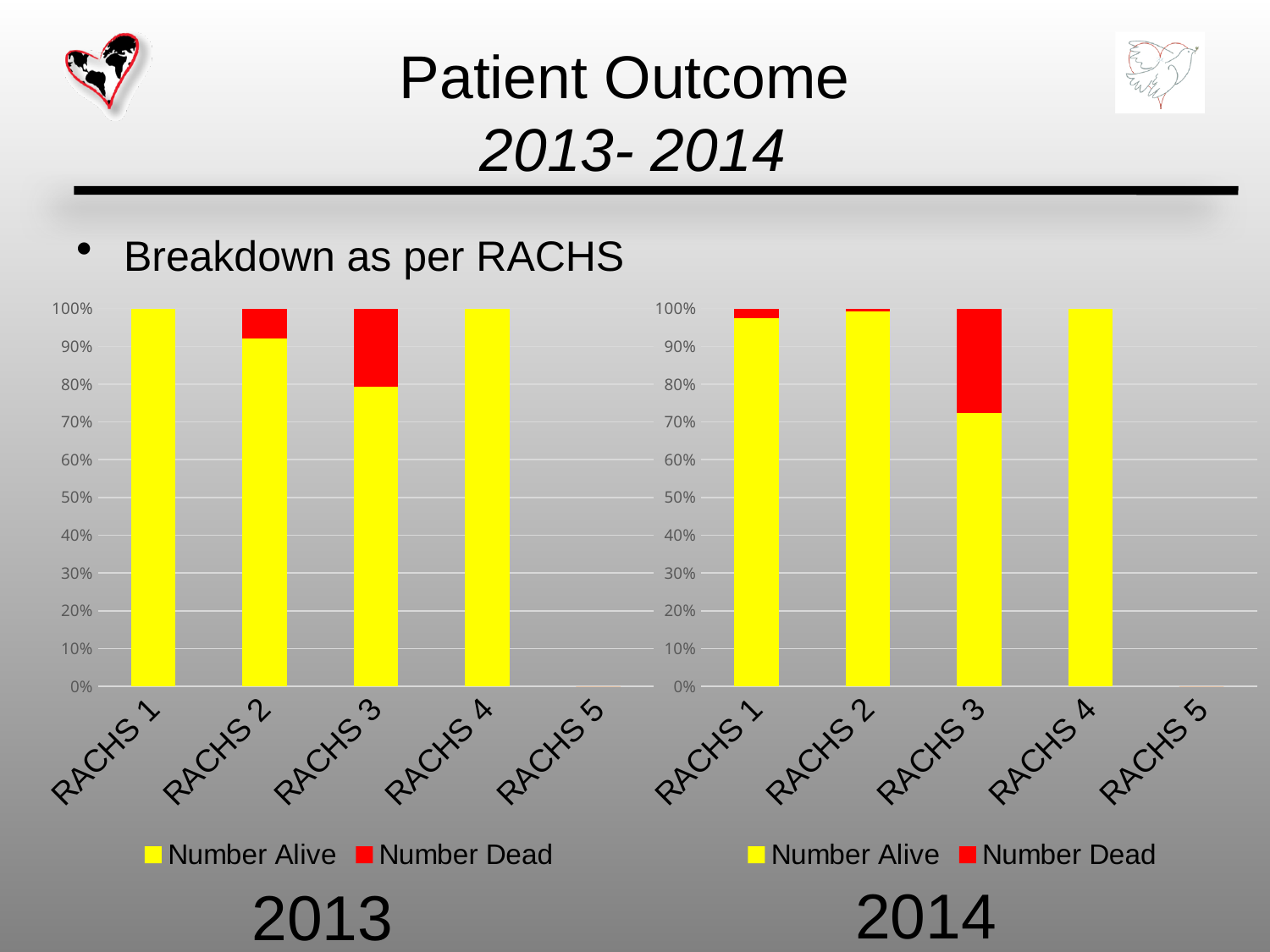
In the 2014 chart, which RACHS category has the largest share of Number Dead? RACHS 3 What kind of chart is the 2013 chart? Stacked bar chart How many RACHS categories are labelled on the x axis of the 2013 chart? 5 In the 2013 chart, is the Number Alive share for RACHS 2 greater or less than 90%? greater In the 2013 chart, what is the Number Alive share for RACHS 4? 100% In the 2013 chart, which RACHS category has the lowest share of Number Alive? RACHS 3 Which colour represents Number Dead in the charts? Red How many series does the legend of the 2014 chart list? 2 In the 2014 chart, what is the Number Alive share for RACHS 4? 100% In the 2013 chart, which has the larger Number Dead share, RACHS 2 or RACHS 3? RACHS 3 In the 2014 chart, is the Number Alive share for RACHS 3 greater or less than 80%? less What year is shown below the right-hand chart? 2014